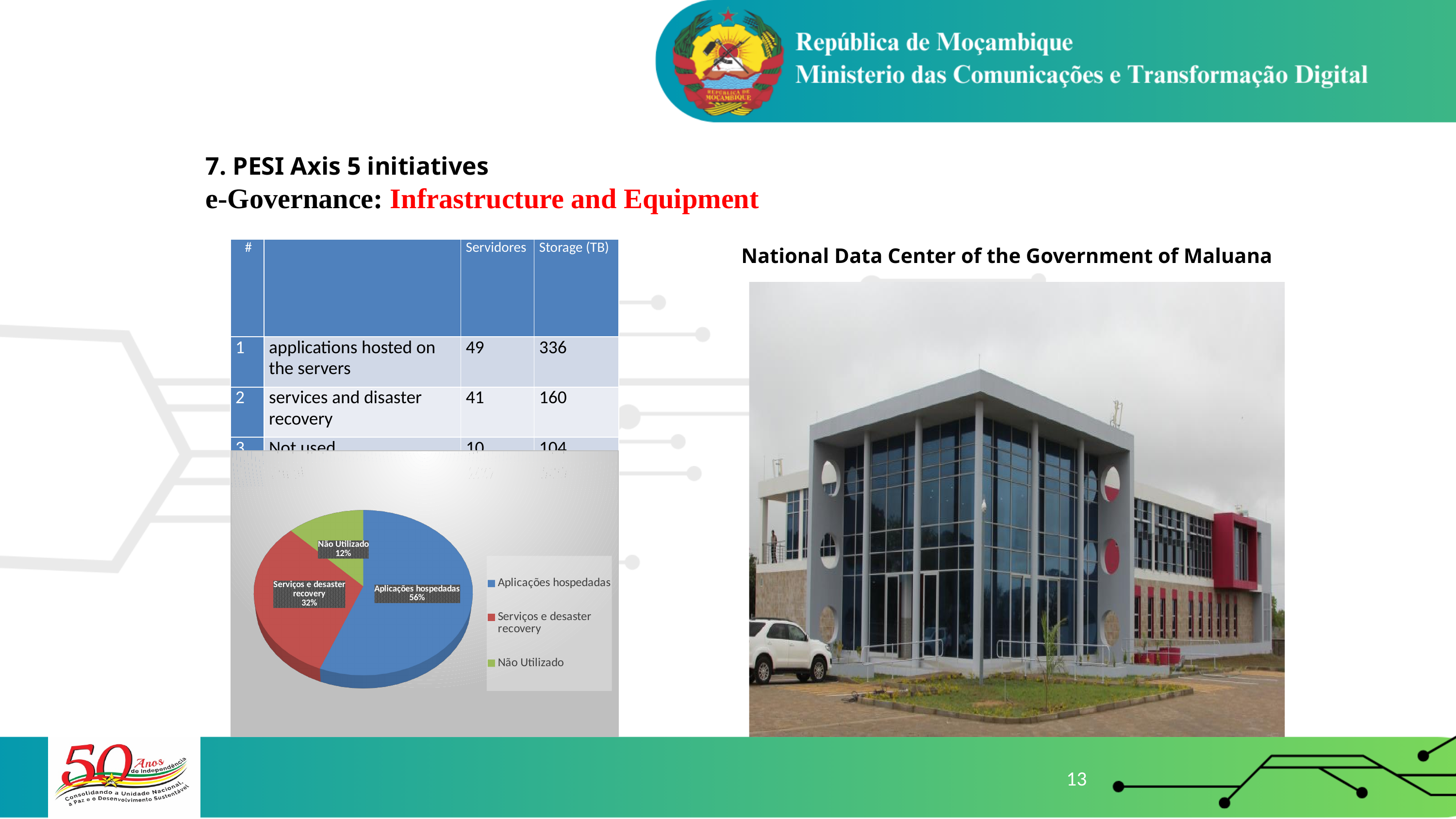
What is the difference in percentage points between the Serviços e desaster recovery slice and the Não Utilizado slice? 20 What share of the pie chart does Não Utilizado represent? 12% How many slices does the pie chart have? 3 What is the difference in percentage points between the Aplicações hospedadas slice and the Serviços e desaster recovery slice? 24 Which slice of the pie chart is the smallest? Não Utilizado What share of the pie chart does Serviços e desaster recovery represent? 32% What colour is the Não Utilizado slice in the pie chart? Green How many entries does the pie chart's legend list? 3 Which is larger in the pie chart: Serviços e desaster recovery or Não Utilizado? Serviços e desaster recovery What kind of chart is shown on the slide? Pie chart What share of the pie chart does Aplicações hospedadas represent? 56% Which slice of the pie chart is the largest? Aplicações hospedadas